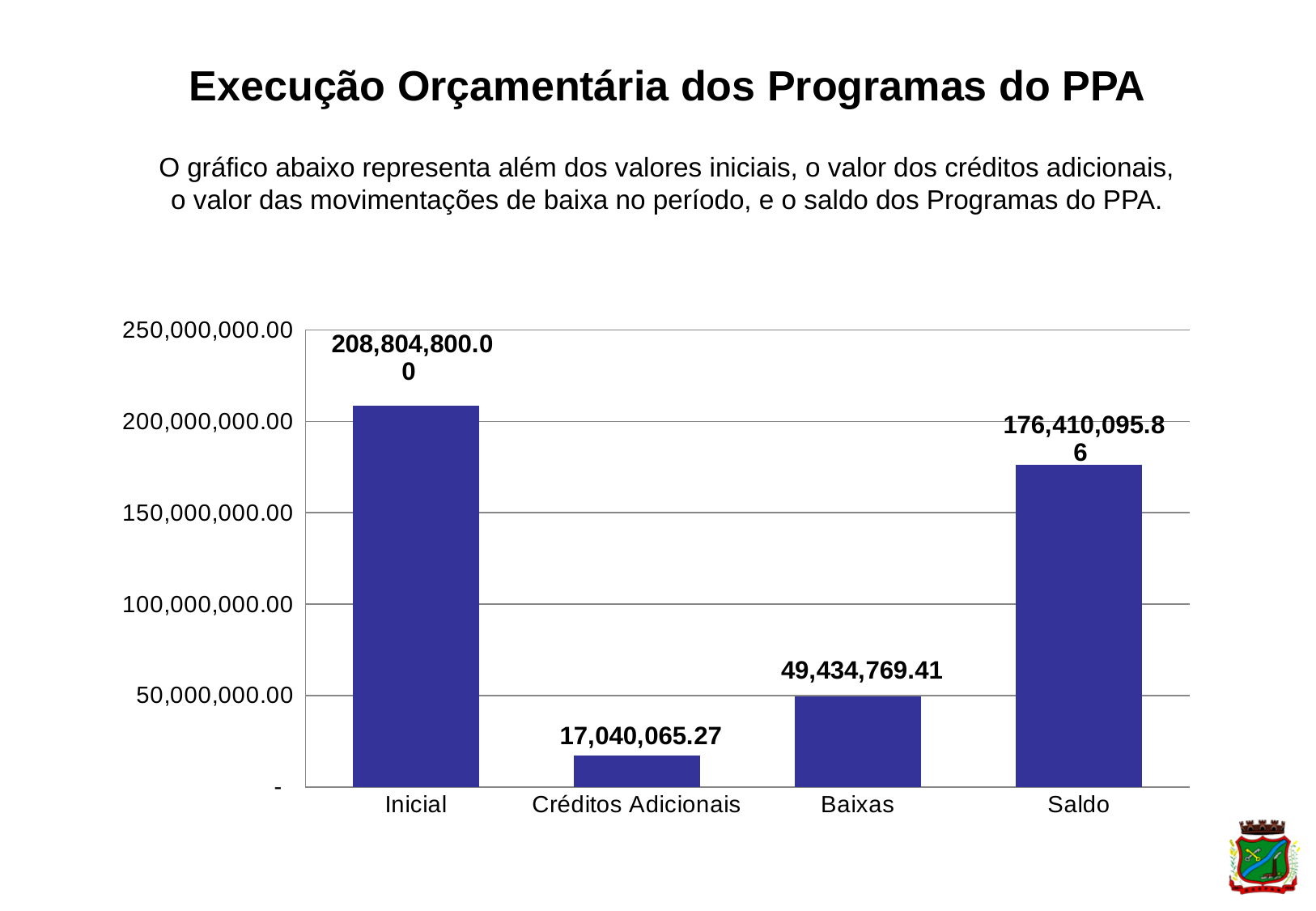
Is the value for Saldo greater or less than 150,000,000.00? greater What is the difference between the Baixas value and the Créditos Adicionais value? 32,394,704.14 How many categories are shown on the x axis of the chart? 4 What is the value shown for Baixas? 49,434,769.41 Which category has the lowest value? Créditos Adicionais What kind of chart is shown on the slide? bar chart What is the difference between the Inicial value and the Saldo value? 32,394,704.14 Which is larger, the value for Baixas or the value for Créditos Adicionais? Baixas Which category has the highest value? Inicial What is the value shown for Créditos Adicionais? 17,040,065.27 What is the value of the Inicial bar? 208,804,800.00 What is the value of the Saldo bar? 176,410,095.86